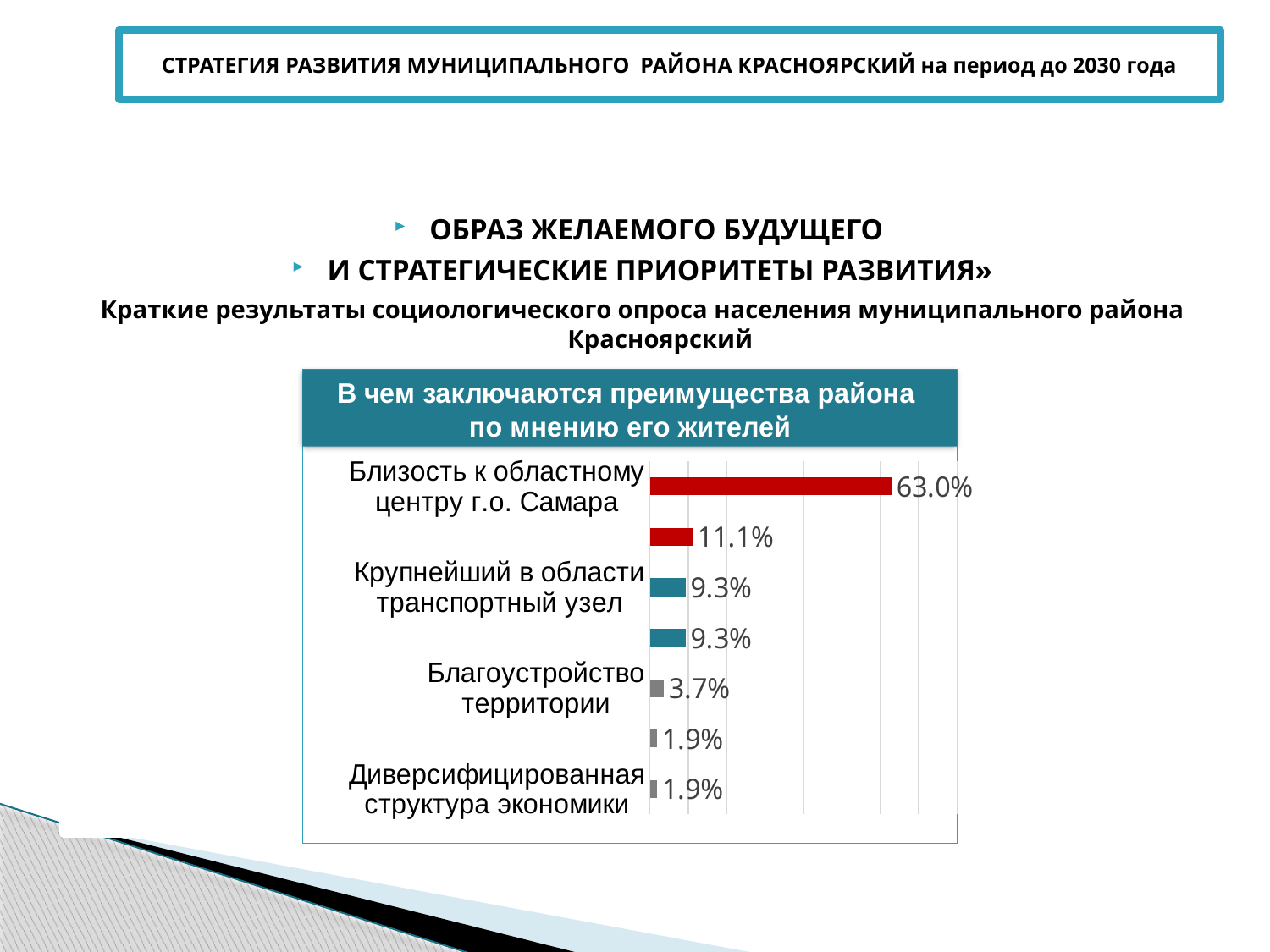
How many bars are plotted in the chart? 7 Which category has the highest value? Близость к областному центру г.о. Самара What is the value for «Близость к областному центру г.о. Самара»? 63.0% What is the value for «Диверсифицированная структура экономики»? 1.9% What is the value for «Благоустройство территории»? 3.7% What colour is the bar for «Близость к областному центру г.о. Самара»? Red What is the difference between the values for «Благоустройство территории» and «Диверсифицированная структура экономики»? 1.8% Which is larger: the value for «Крупнейший в области транспортный узел» or for «Благоустройство территории»? Крупнейший в области транспортный узел What kind of chart is shown? Bar chart What is the value for «Крупнейший в области транспортный узел»? 9.3% What is the title of the chart? В чем заключаются преимущества района по мнению его жителей What is the difference between the values for «Близость к областному центру г.о. Самара» and «Крупнейший в области транспортный узел»? 53.7%